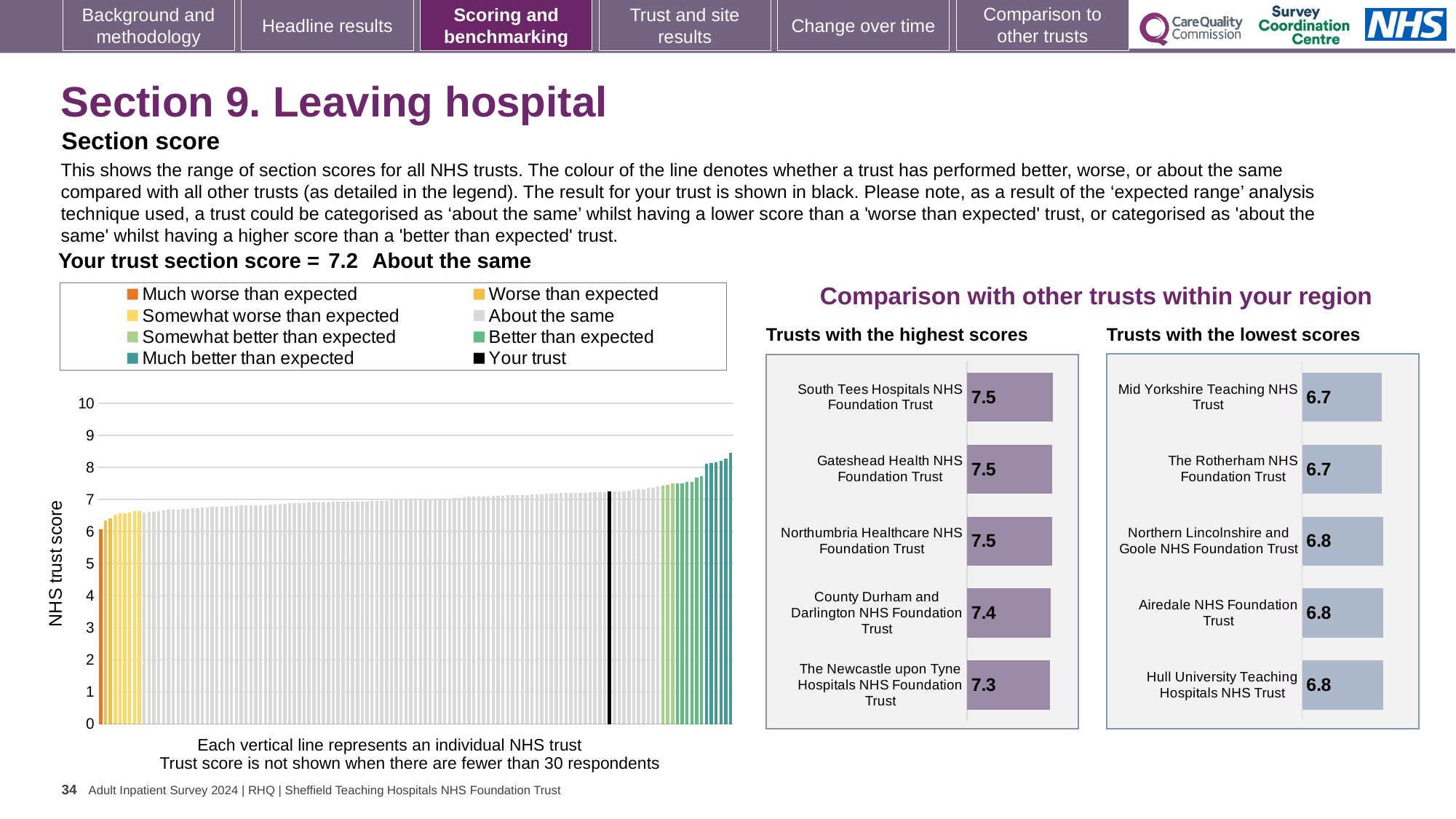
In the 'Trusts with the highest scores' chart, what is the difference between the scores of South Tees Hospitals NHS Foundation Trust and The Newcastle upon Tyne Hospitals NHS Foundation Trust? 0.2 How many trusts are shown in the 'Trusts with the lowest scores' chart? 5 In the 'Trusts with the lowest scores' chart, which is larger: the score for Hull University Teaching Hospitals NHS Trust or Mid Yorkshire Teaching NHS Trust? Hull University Teaching Hospitals NHS Trust In the 'Trusts with the lowest scores' chart, what is the score for Airedale NHS Foundation Trust? 6.8 In the large chart on the left, is the value of the leftmost (orange) bar greater or less than 7? less In the large chart on the left, do the trust scores rise or fall from left to right? Rise In the 'Trusts with the highest scores' chart, what is the score for County Durham and Darlington NHS Foundation Trust? 7.4 How many entries does the legend above the large chart on the left list? 8 What is the label on the vertical axis of the large chart on the left? NHS trust score What kind of chart is the large chart on the left showing NHS trust scores? Bar chart In the large chart on the left, is the value of the rightmost bar greater or less than 8? greater In the 'Trusts with the highest scores' chart, which trust has the lowest score? The Newcastle upon Tyne Hospitals NHS Foundation Trust